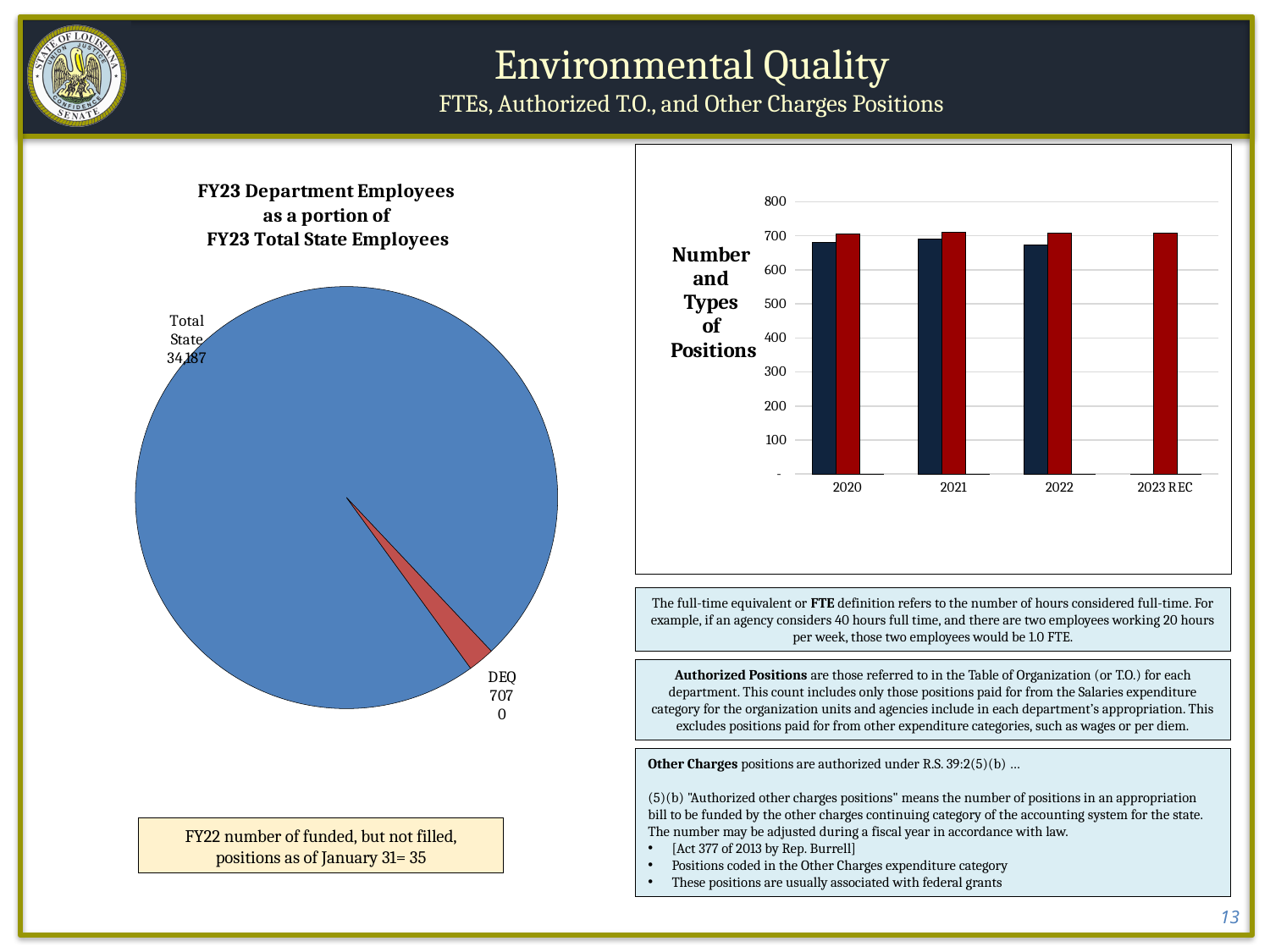
In the pie chart on the left, what is the value shown for DEQ? 707 In the 'Number and Types of Positions' chart, what is the label of the last category on the x axis? 2023 REC In the pie chart on the left, which slice is larger, Total State or DEQ? Total State In the pie chart on the left, what is the difference between the Total State value and the DEQ value? 33,480 In the 'Number and Types of Positions' chart, is the red bar for 2022 greater or less than 800? less In the pie chart on the left, what is the value shown for Total State? 34,187 What kind of chart is the chart on the left of the slide? Pie chart In the 'Number and Types of Positions' chart, which bar is taller for 2021, the dark blue bar or the red bar? The red bar In the 'Number and Types of Positions' chart, how many categories are shown on the x axis? 4 What kind of chart is the 'Number and Types of Positions' chart on the right? Bar chart What is the title of the pie chart on the left of the slide? FY23 Department Employees as a portion of FY23 Total State Employees In the 'Number and Types of Positions' chart, is the dark blue bar for 2020 greater or less than 600? greater